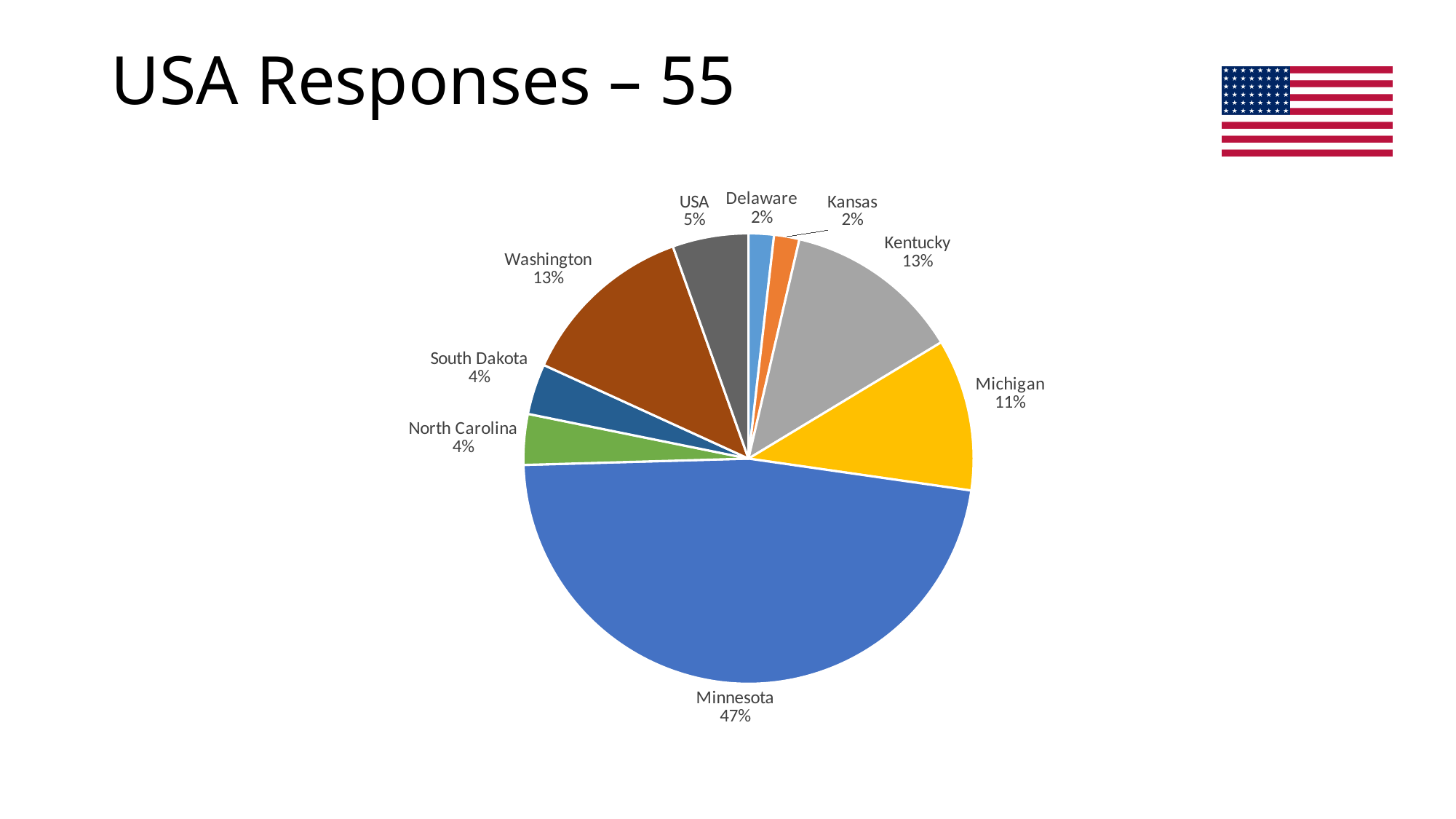
What percentage is shown for Kentucky? 13% What is the difference in percentage points between Minnesota and Kentucky? 34 What is the title of the slide containing the pie chart? USA Responses – 55 What kind of chart is shown on the slide? pie chart Which slice of the pie is the largest? Minnesota What percentage is shown for Michigan? 11% What percentage is shown for South Dakota? 4% How many slices does the pie chart have? 9 What share of the pie does Minnesota have? 47% Which is larger, the share for Michigan or the share for Washington? Washington What percentage is shown for Delaware? 2% What is the difference in percentage points between Michigan and North Carolina? 7